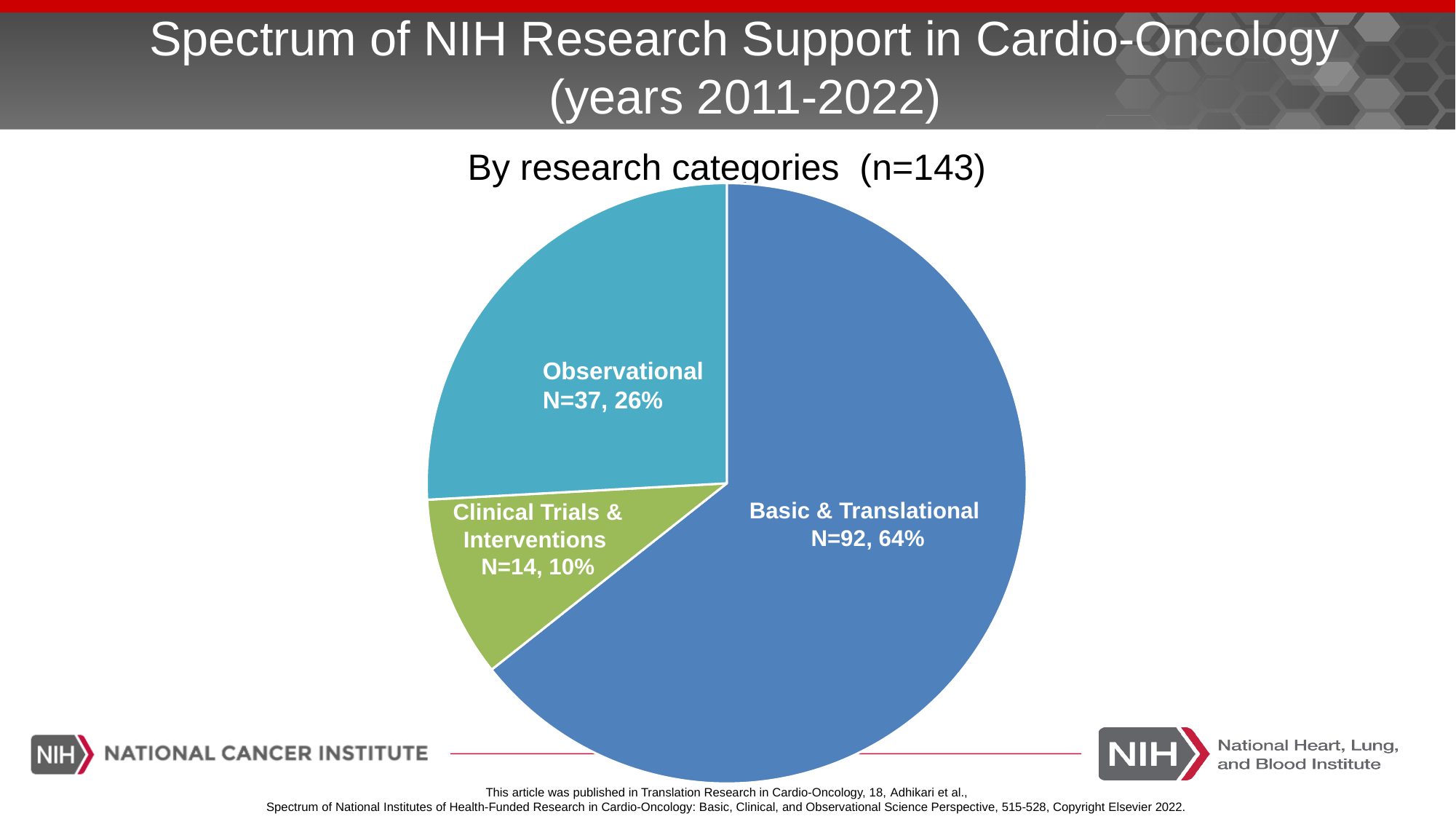
What is the total n given in the chart title? n=143 Which research category has the largest slice of the pie? Basic & Translational How many research categories does the pie chart show? 3 Which has a larger N, Observational or Clinical Trials & Interventions? Observational What kind of chart is shown on the slide? Pie chart What share of the pie does Basic & Translational research account for? 64% How many more projects are in Basic & Translational than in Observational? 55 Which research category has the smallest slice of the pie? Clinical Trials & Interventions What percentage of the pie does Observational research represent? 26% What is the N value for Clinical Trials & Interventions? N=14 What colour is the Clinical Trials & Interventions slice? Green What is the N value for Basic & Translational research? N=92